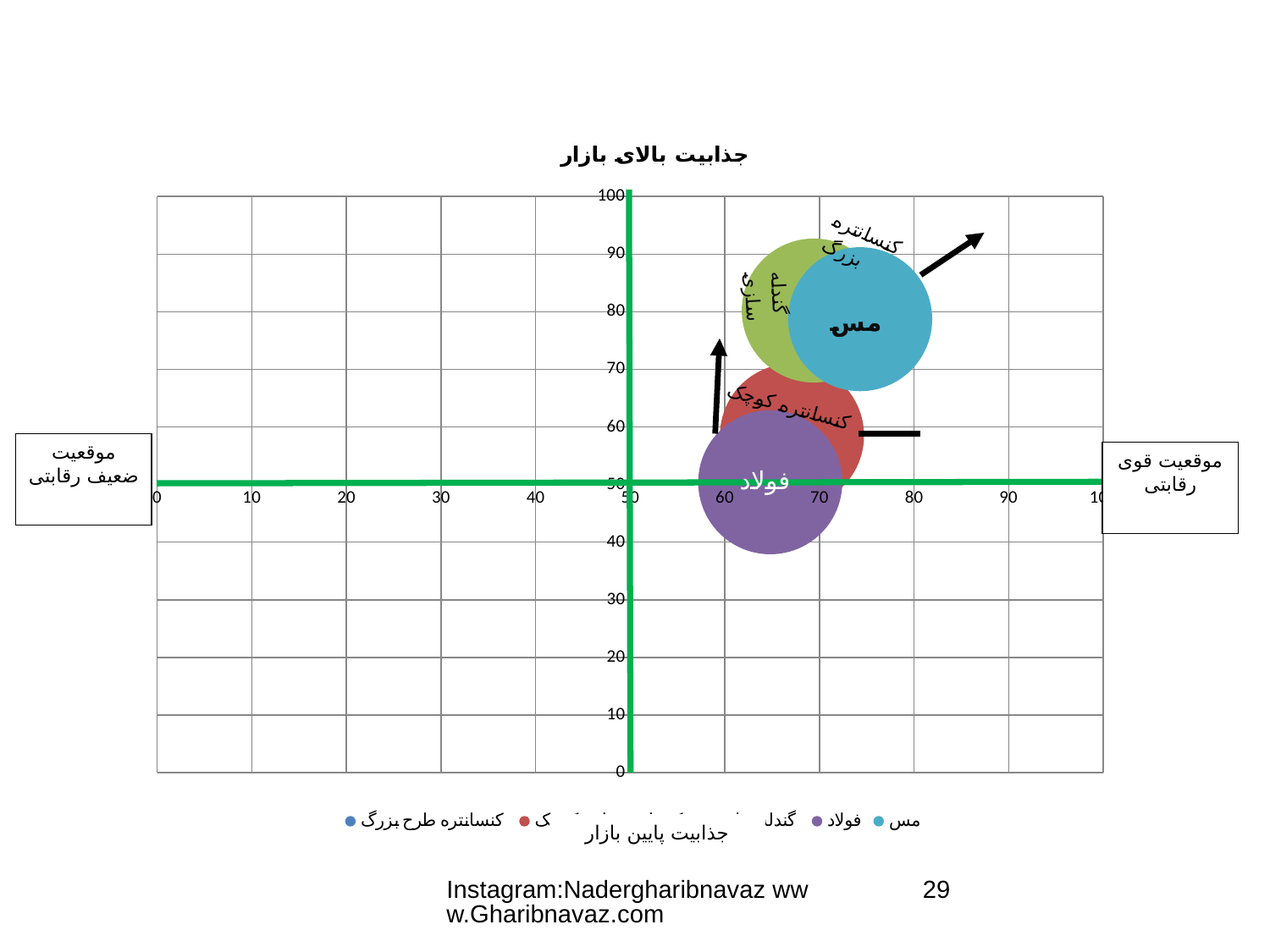
Which bubble is furthest to the right on the horizontal axis? مس Is the vertical-axis value for the گندله سازی bubble greater or less than 70? greater Is the horizontal-axis value for the مس bubble greater or less than 70? greater What label appears at the right end of the horizontal axis? موقعیت قوی رقابتی Is the vertical-axis value for the فولاد bubble greater or less than 60? less What is the title shown above the chart? جذابیت بالای بازار Which bubble is higher on the vertical axis, مس or فولاد? مس How many bubbles are plotted on the chart? 4 Which bubble is lowest on the vertical axis? فولاد What kind of chart is shown on the slide? Bubble chart